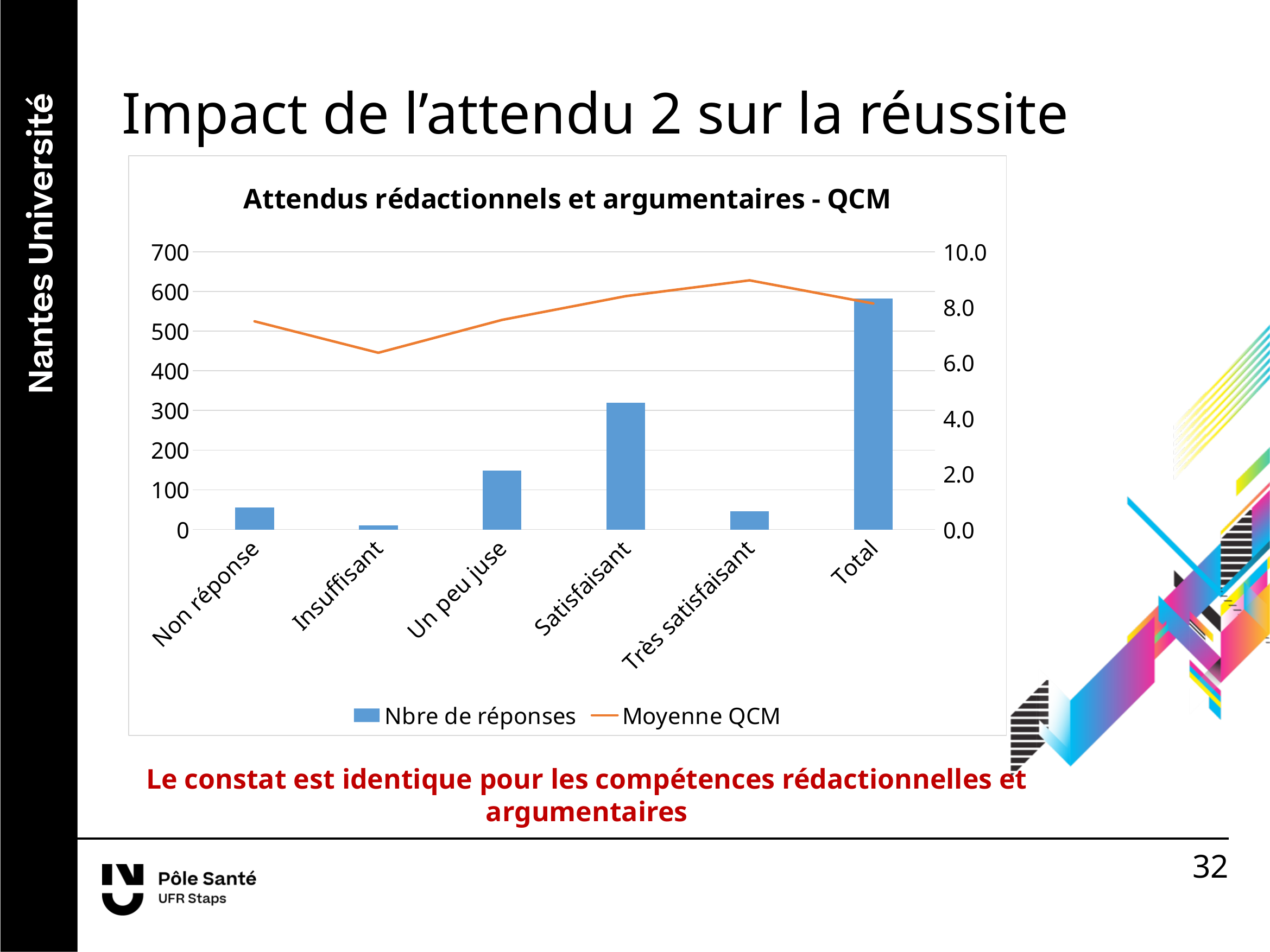
Is the Moyenne QCM for Insuffisant greater or less than 8.0? less Which category has the highest bar for Nbre de réponses? Total Which category has the highest Moyenne QCM? Très satisfaisant Which category has the lowest bar for Nbre de réponses? Insuffisant What kind of chart is shown on the slide? A combined bar and line chart What are the two series named in the legend? Nbre de réponses and Moyenne QCM How many categories are shown on the x axis? 6 How many series does the legend list? 2 Is the Nbre de réponses value for Satisfaisant greater or less than 200? greater Which has more Nbre de réponses, Un peu juse or Très satisfaisant? Un peu juse What is the title of the chart? Attendus rédactionnels et argumentaires - QCM Is the Nbre de réponses value for Un peu juse greater or less than 200? less